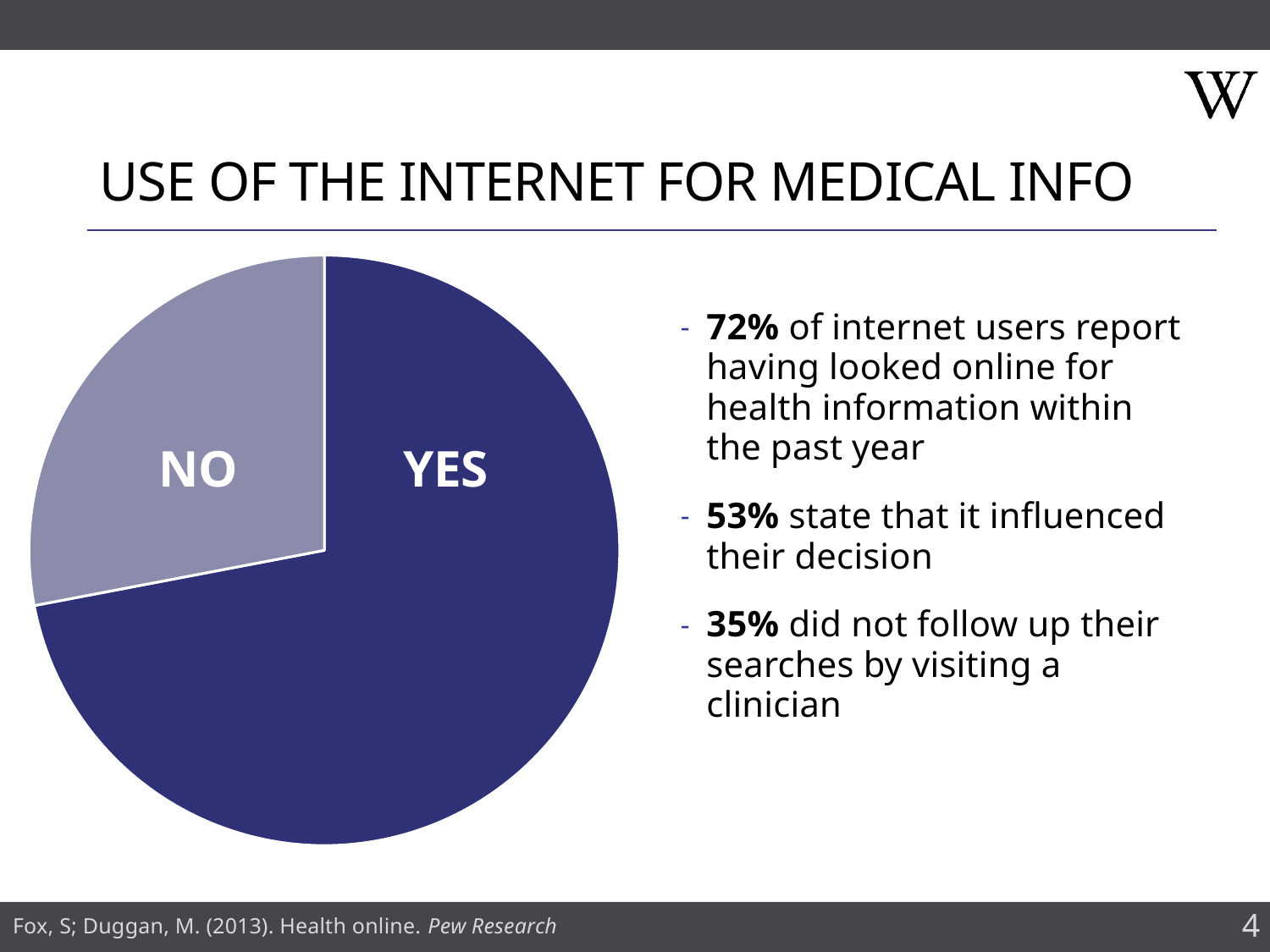
What kind of chart is shown on the slide? Pie chart Does the NO slice take up more or less than half of the pie chart? less Does the YES slice take up more or less than half of the pie chart? more What are the labels of the two slices in the pie chart? NO and YES Which slice of the pie chart is the smallest? NO What is the title of the slide containing the pie chart? USE OF THE INTERNET FOR MEDICAL INFO How many slices does the pie chart have? 2 Which slice of the pie chart is the largest? YES Which slice is larger in the pie chart, YES or NO? YES